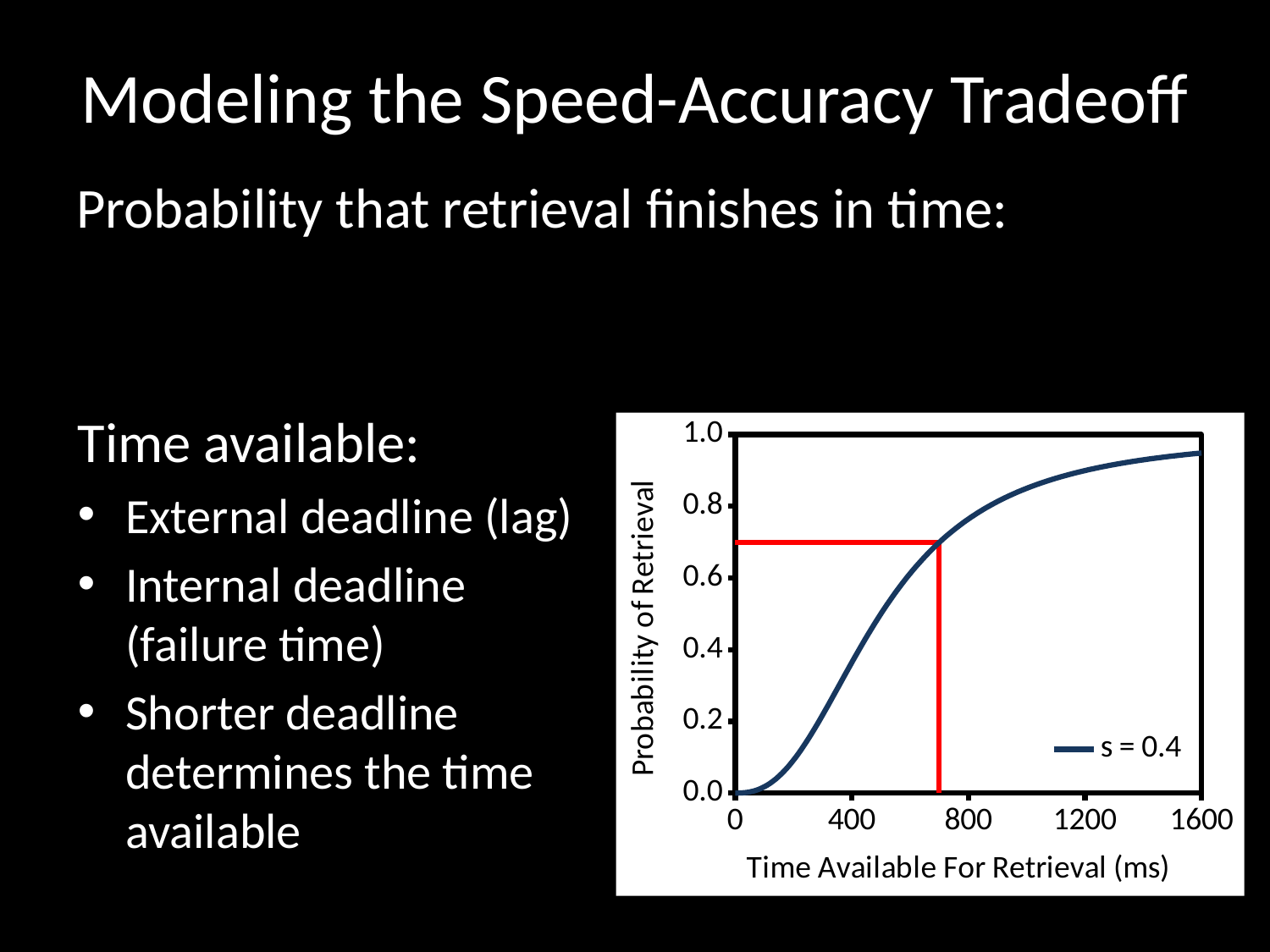
Is the probability of retrieval at 200 ms greater or less than 0.4? less Is the probability of retrieval at 400 ms greater or less than 0.6? less What is the title of the x axis of the chart? Time Available For Retrieval (ms) Which has the higher probability of retrieval: 400 ms or 1200 ms of time available? 1200 ms Does the probability of retrieval rise or fall as time available increases along the x axis? rise Is the probability of retrieval at 1600 ms greater or less than 0.8? greater What is the legend entry for the plotted line? s = 0.4 What is the largest value shown on the x axis of the chart? 1600 What kind of chart is shown on the slide? line chart How many series does the chart's legend list? 1